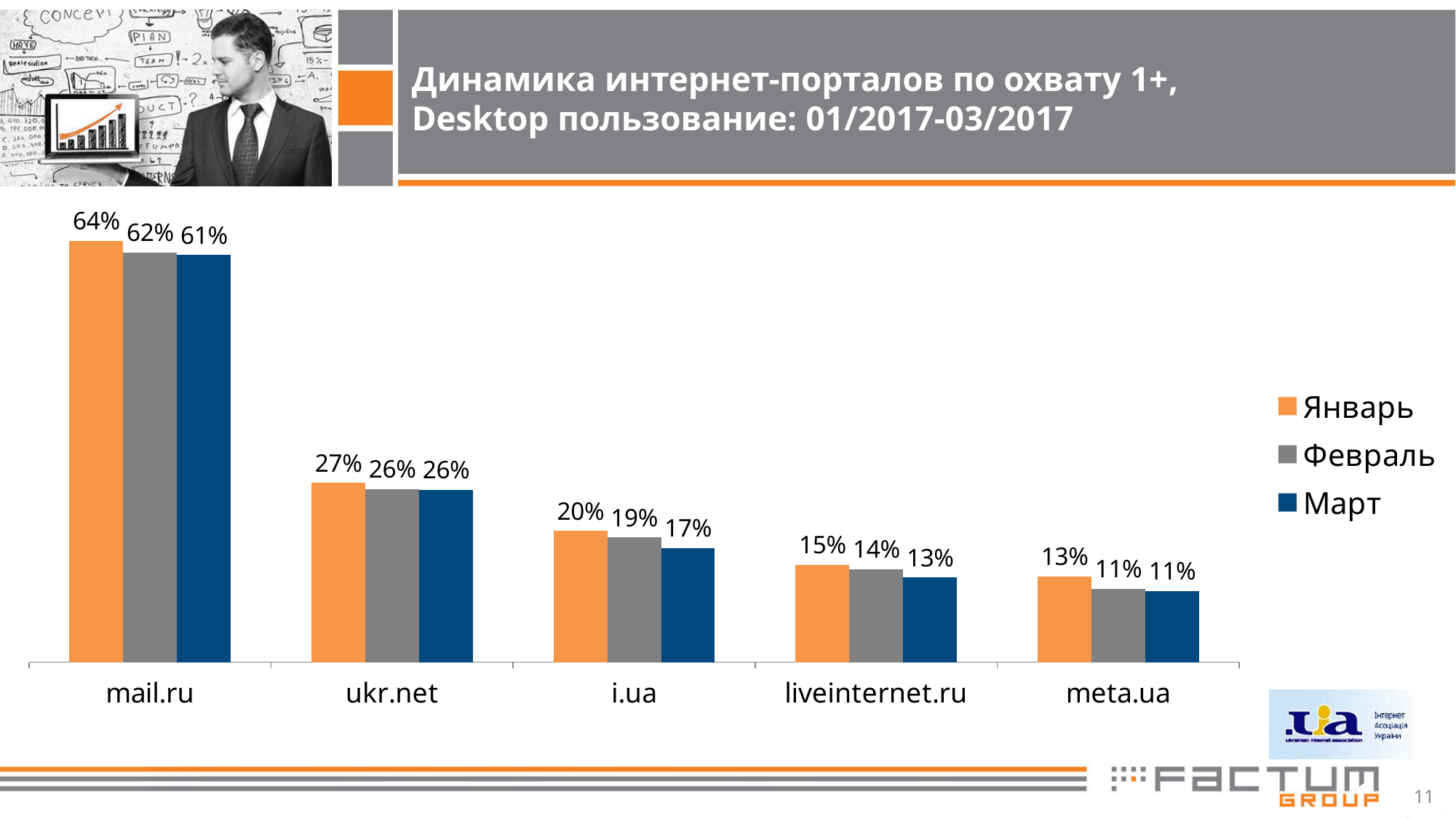
Do the values for i.ua rise or fall from Январь to Март? Fall What kind of chart is shown on the slide? Bar chart What is the value for mail.ru in Январь? 64% What is the value for ukr.net in Март? 26% Which portal has the highest value in Январь? mail.ru Which portal has the lowest value in Март? meta.ua What is the difference between the Январь and Март values for mail.ru? 3% How many series does the legend list? 3 Which is larger: the Январь value for i.ua or the Январь value for liveinternet.ru? i.ua What is the value for liveinternet.ru in Март? 13% How many portals are shown on the x axis? 5 What is the value for i.ua in Февраль? 19%